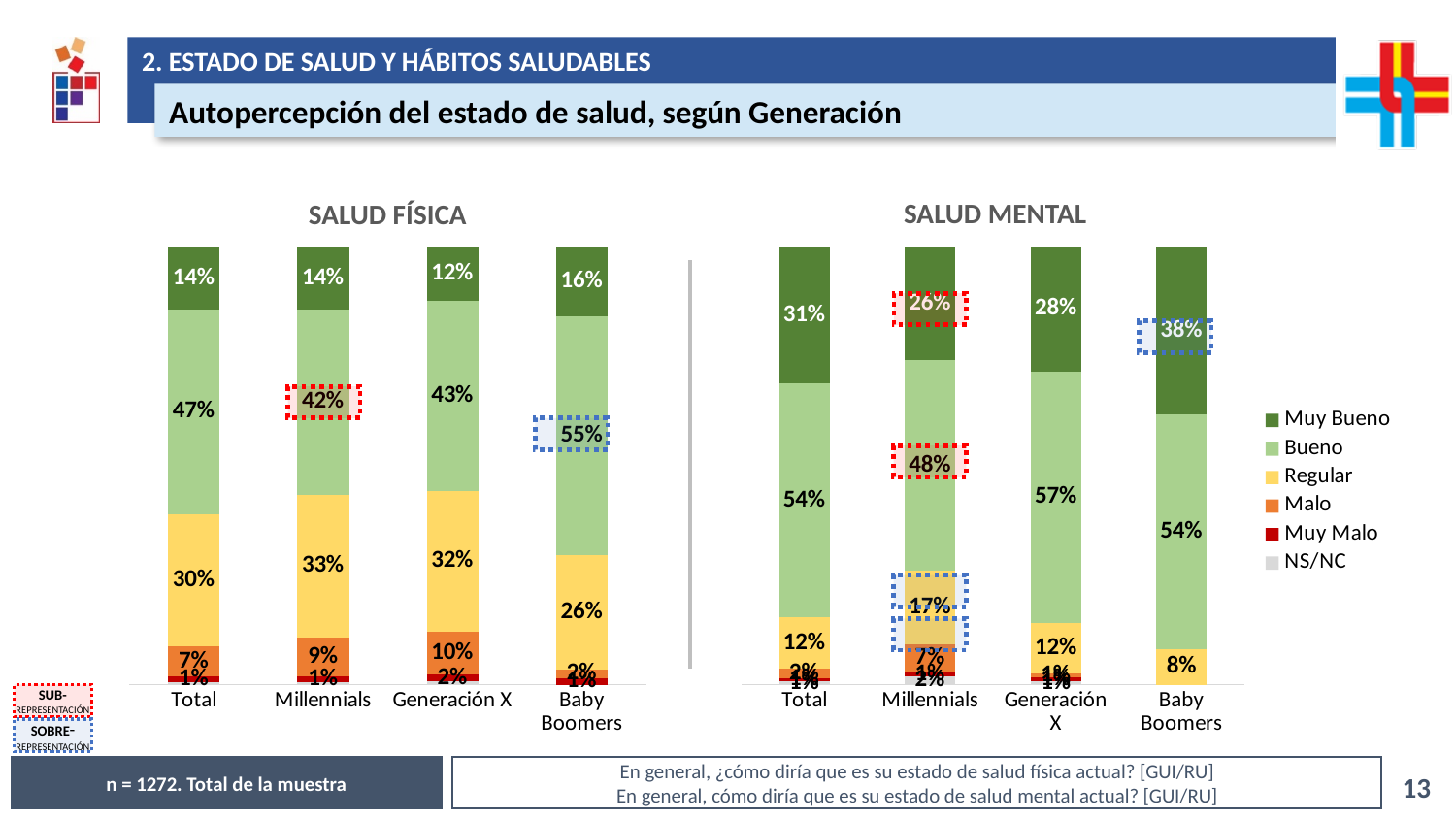
In the SALUD MENTAL chart, what is the Muy Bueno value for Baby Boomers? 38% In the SALUD FÍSICA chart, what is the Muy Bueno value for Generación X? 12% What kind of chart is the SALUD MENTAL chart? Stacked bar chart How many series does the legend list? 6 How many categories are shown on the x axis of the SALUD FÍSICA chart? 4 In the SALUD FÍSICA chart, what is the difference between the Bueno values for Baby Boomers and Millennials? 13% In the SALUD FÍSICA chart, what is the Regular value for Millennials? 33% In the SALUD FÍSICA chart, what is the Bueno value for Baby Boomers? 55% In the SALUD MENTAL chart, what is the Bueno value for Generación X? 57% In the SALUD FÍSICA chart, which category has the lowest Regular value? Baby Boomers In the SALUD MENTAL chart, is the Bueno value for Millennials larger or smaller than the Bueno value for Total? smaller In the SALUD MENTAL chart, which generation has the highest Muy Bueno value? Baby Boomers